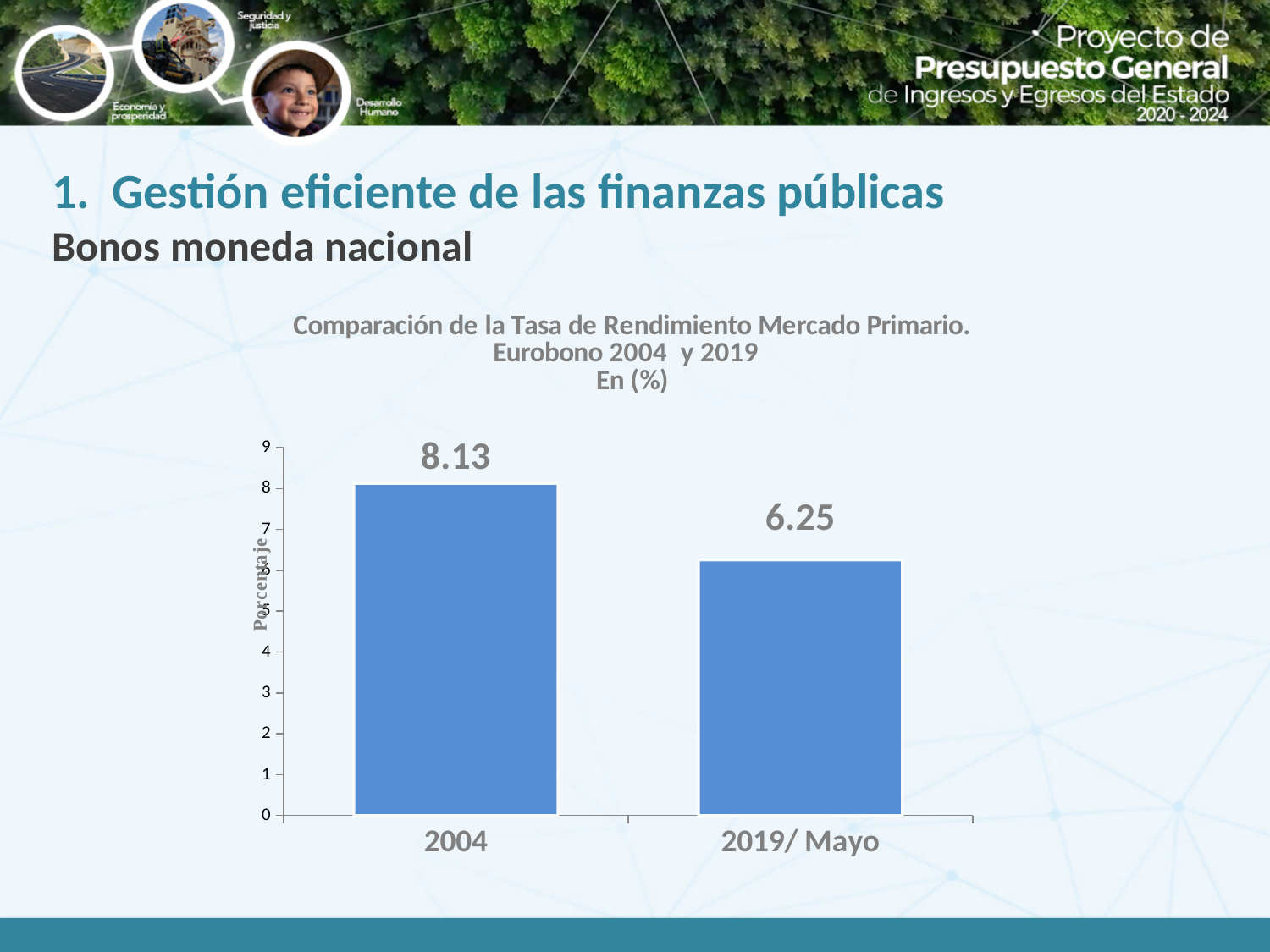
Is the value for 2019/ Mayo greater or less than 7? less What is the value for 2019/ Mayo? 6.25 What is the difference between the values for 2004 and 2019/ Mayo? 1.88 What is the label of the vertical axis? Porcentaje What is the value for 2004? 8.13 How many categories are shown on the x axis? 2 Which category has the lowest value? 2019/ Mayo Which category has the highest value? 2004 Do the values rise or fall from 2004 to 2019/ Mayo? fall Is the value for 2004 greater or less than 8? greater Which is larger, the value for 2004 or the value for 2019/ Mayo? 2004 What kind of chart is shown on the slide? bar chart